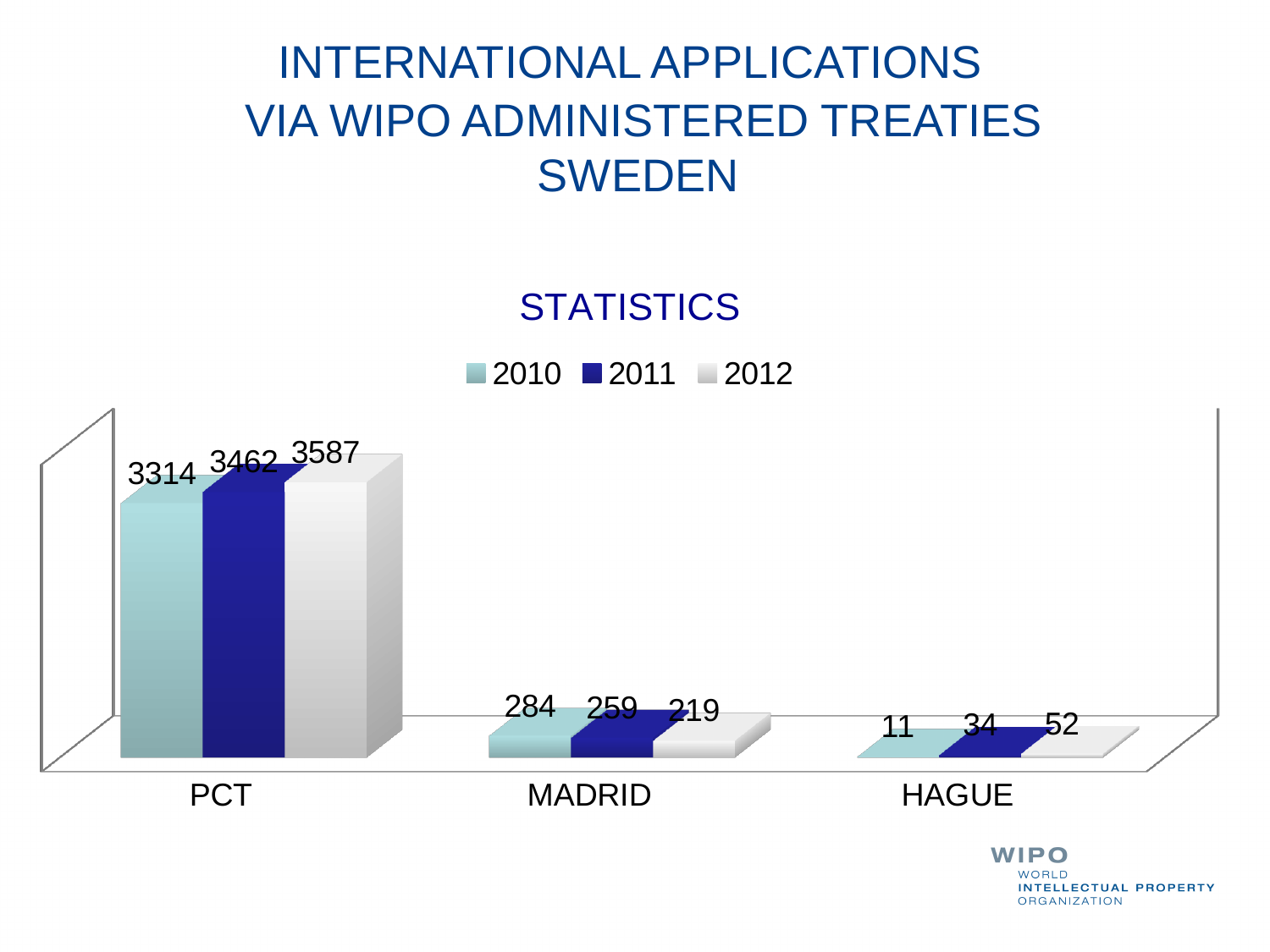
How many series does the legend list? 3 What is the value for HAGUE in 2011? 34 Do the MADRID values rise or fall from 2010 to 2012? Fall Which category has the lowest value in 2010? HAGUE How many categories are shown on the x axis? 3 What is the difference between the PCT values for 2012 and 2010? 273 Which is larger, the HAGUE value for 2012 or the HAGUE value for 2010? 2012 What is the value for PCT in 2012? 3587 What is the value for MADRID in 2010? 284 What kind of chart is shown on the slide? Bar chart Which category has the highest value in 2011? PCT What is the difference between the MADRID values for 2010 and 2012? 65